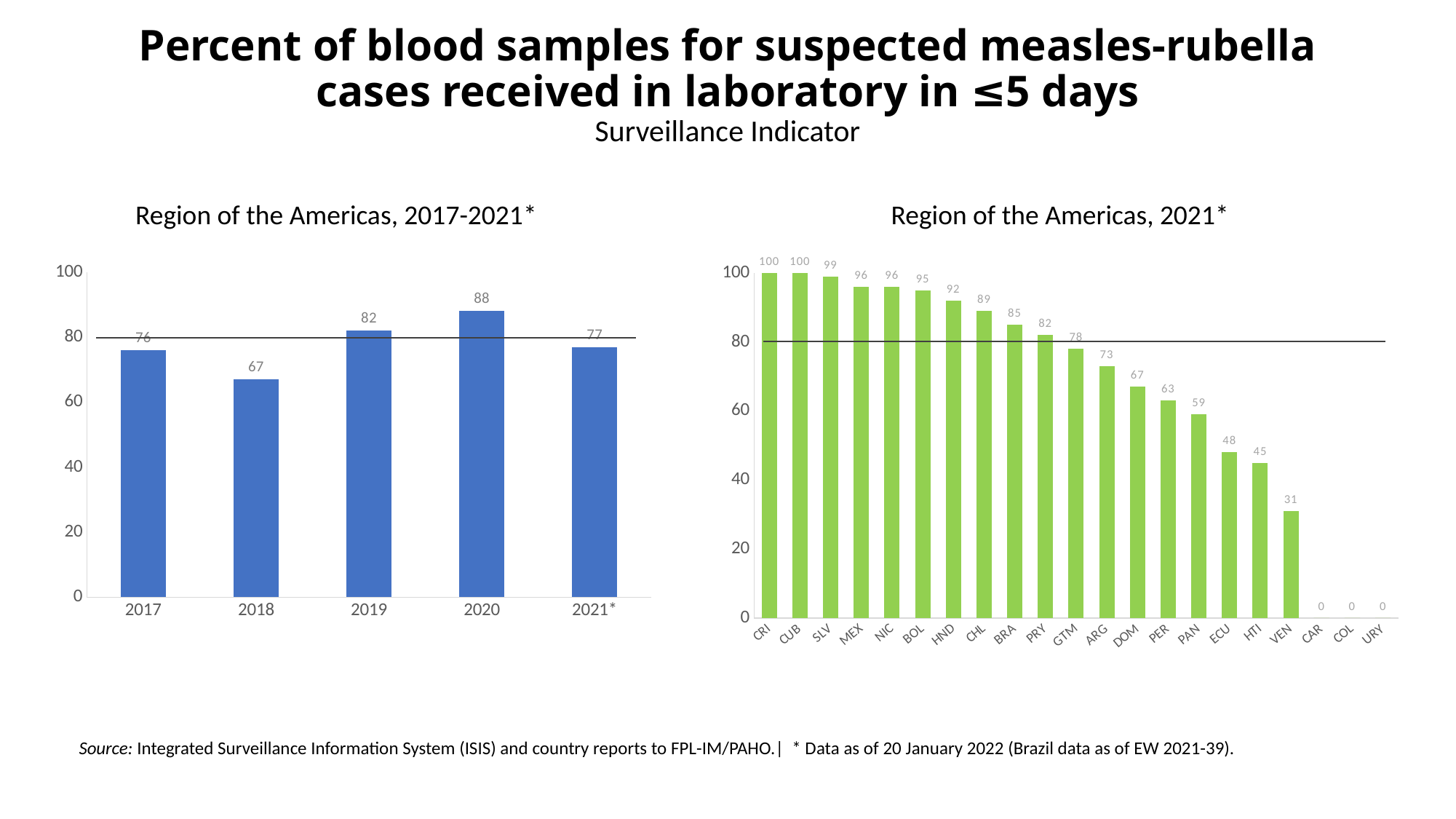
In the 'Region of the Americas, 2017-2021*' chart, which year has the lowest value? 2018 In the 'Region of the Americas, 2021*' chart, how many countries are plotted? 21 What type of chart is the 'Region of the Americas, 2021*' chart? Bar chart In the 'Region of the Americas, 2017-2021*' chart, is the value for 2019 larger than the value for 2021*? Yes, 2019 In the 'Region of the Americas, 2017-2021*' chart, how many years are plotted? 5 In the 'Region of the Americas, 2017-2021*' chart, what is the difference between the values for 2020 and 2018? 21 In the 'Region of the Americas, 2021*' chart, what is the difference between the values for GTM and PER? 15 What colour are the bars in the 'Region of the Americas, 2017-2021*' chart? Blue In the 'Region of the Americas, 2021*' chart, which countries have a value of 0? CAR, COL, URY In the 'Region of the Americas, 2017-2021*' chart, what is the value for 2020? 88 In the 'Region of the Americas, 2021*' chart, what is the value for VEN? 31 In the 'Region of the Americas, 2021*' chart, what is the value for BRA? 85